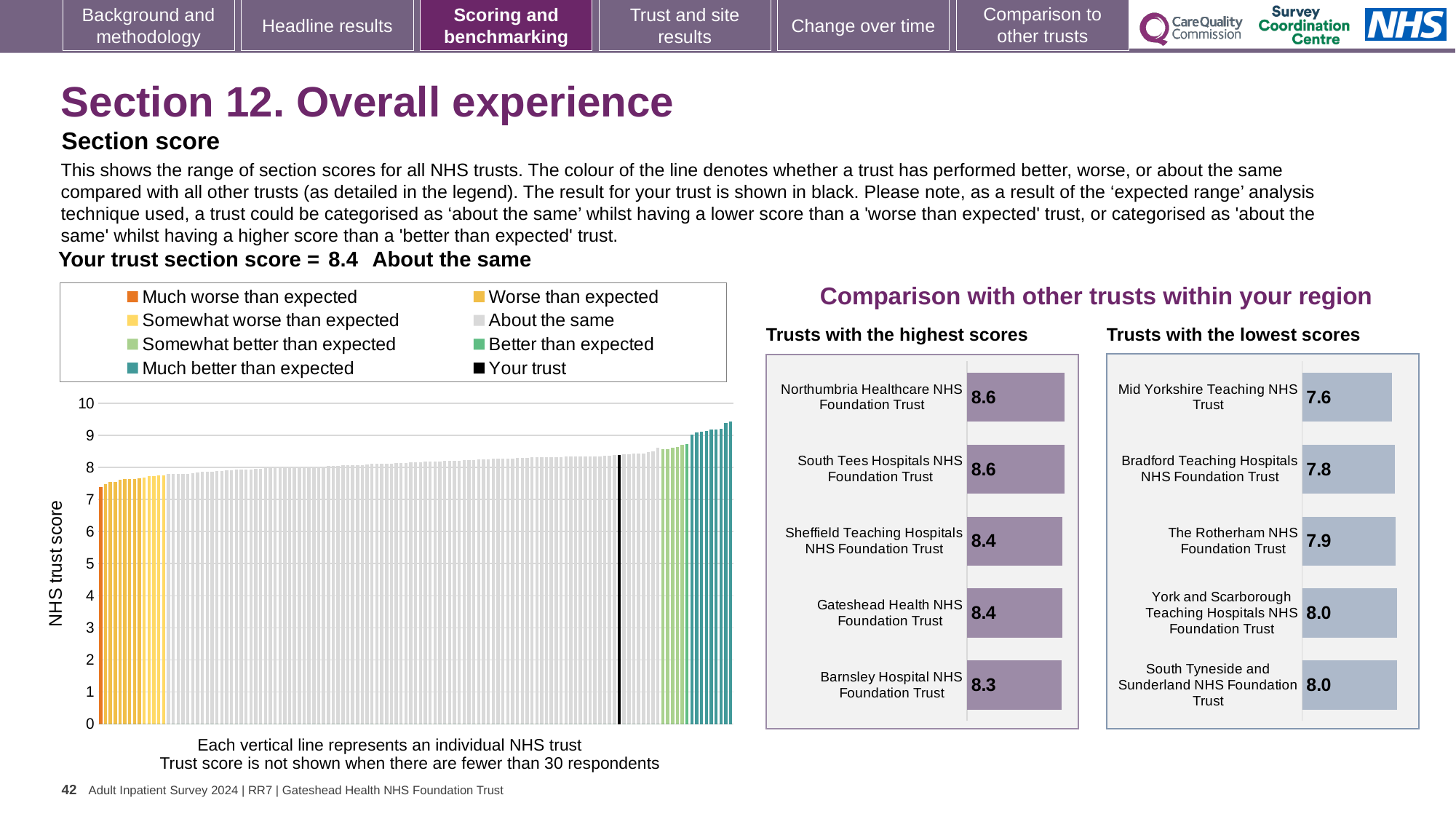
In the 'Trusts with the lowest scores' chart, what is the score for Mid Yorkshire Teaching NHS Trust? 7.6 In the 'Trusts with the highest scores' chart, what is the difference between the scores of South Tees Hospitals NHS Foundation Trust and Barnsley Hospital NHS Foundation Trust? 0.3 In the 'Trusts with the lowest scores' chart, which trust has the lowest score? Mid Yorkshire Teaching NHS Trust What kind of chart is the large chart on the left showing NHS trust scores? Bar chart In the 'Trusts with the lowest scores' chart, what is the difference between the scores of Bradford Teaching Hospitals NHS Foundation Trust and Mid Yorkshire Teaching NHS Trust? 0.2 In the 'Trusts with the lowest scores' chart, what is the score for The Rotherham NHS Foundation Trust? 7.9 In the 'Trusts with the lowest scores' chart, which is larger: the score for The Rotherham NHS Foundation Trust or the score for Mid Yorkshire Teaching NHS Trust? The Rotherham NHS Foundation Trust In the large chart on the left showing NHS trust scores, is the value for the black 'Your trust' bar greater or less than 8? greater How many trusts are listed in the 'Trusts with the highest scores' chart? 5 How many entries does the legend of the large chart on the left list? 8 In the 'Trusts with the highest scores' chart, what is the score for Barnsley Hospital NHS Foundation Trust? 8.3 In the 'Trusts with the highest scores' chart, what is the score for Northumbria Healthcare NHS Foundation Trust? 8.6